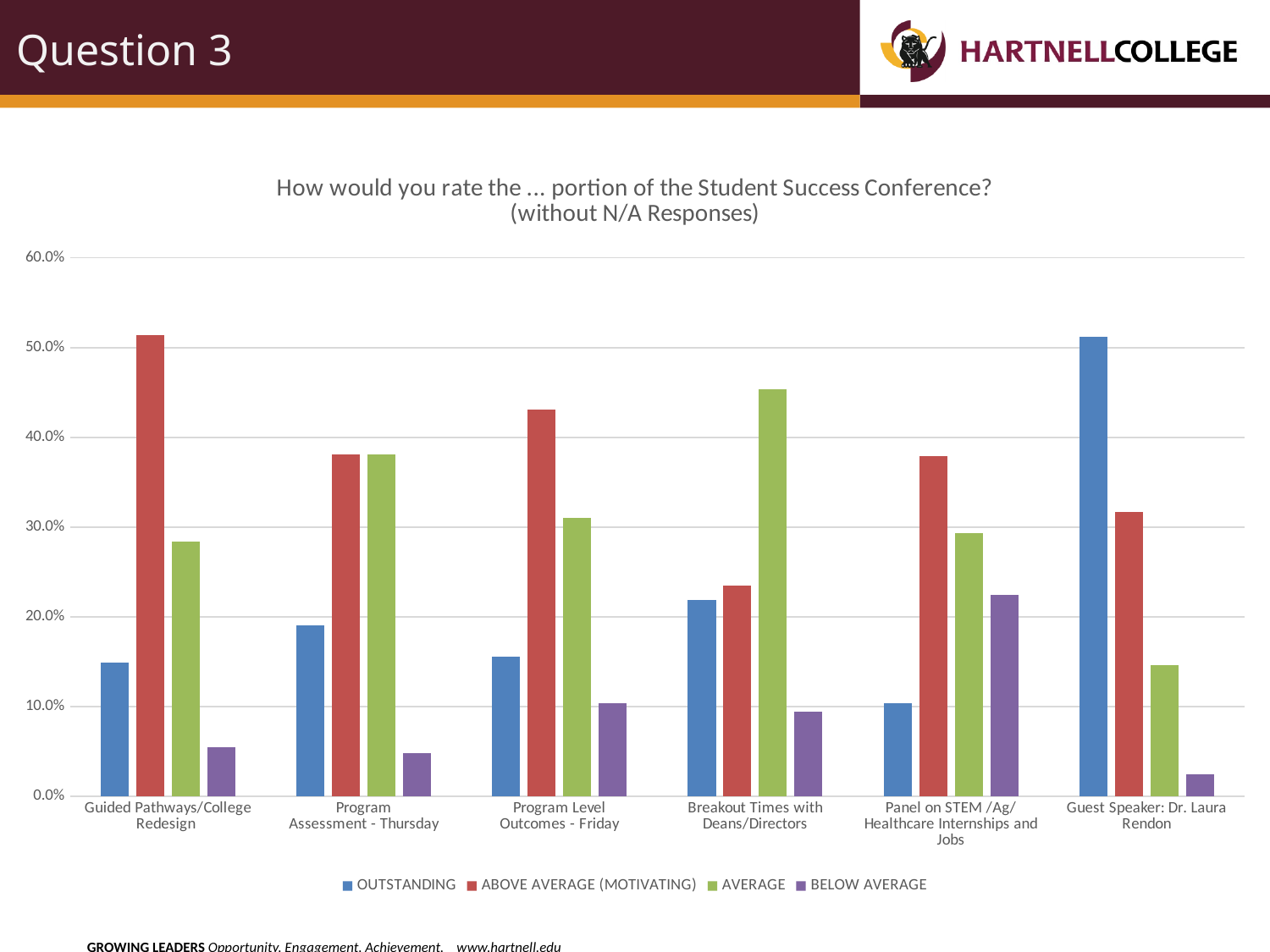
How many conference portions (categories) are shown on the x axis? 6 Which colour represents the AVERAGE series in the legend? green Which conference portion has the highest OUTSTANDING rating? Guest Speaker: Dr. Laura Rendon Is the ABOVE AVERAGE (MOTIVATING) value for Guided Pathways/College Redesign greater or less than 50.0%? greater What kind of chart is shown on the slide? bar chart Is the AVERAGE value for Breakout Times with Deans/Directors greater or less than 40.0%? greater For Guest Speaker: Dr. Laura Rendon, which is larger: the OUTSTANDING value or the ABOVE AVERAGE (MOTIVATING) value? OUTSTANDING Which conference portion has the lowest BELOW AVERAGE rating? Guest Speaker: Dr. Laura Rendon Which conference portion has the highest BELOW AVERAGE rating? Panel on STEM /Ag/ Healthcare Internships and Jobs How many series does the legend list? 4 Is the OUTSTANDING value for Panel on STEM /Ag/ Healthcare Internships and Jobs greater or less than 20.0%? less Which conference portion has the highest AVERAGE rating? Breakout Times with Deans/Directors